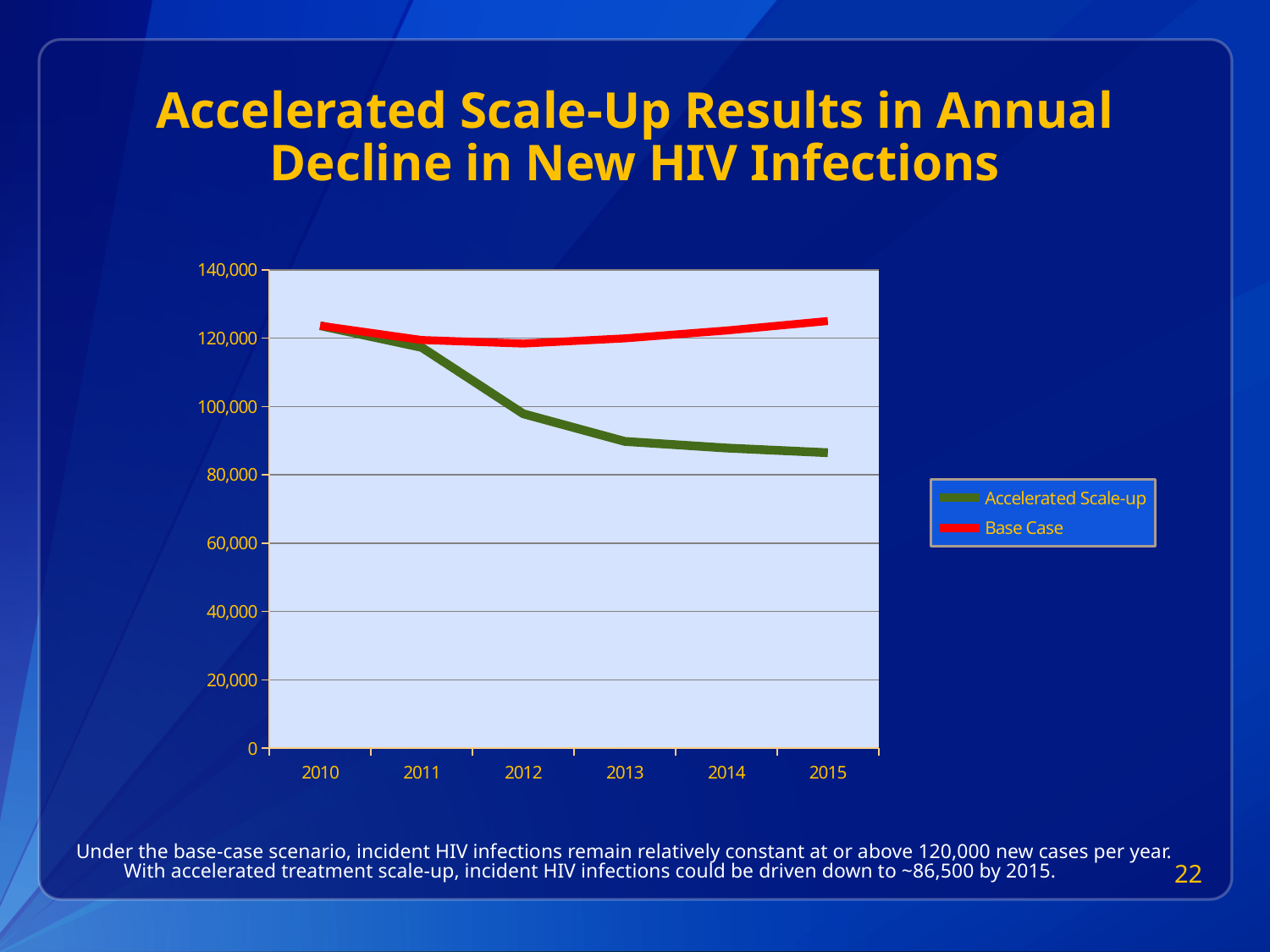
In 2015, which series has the higher value, Base Case or Accelerated Scale-up? Base Case Is the value for Accelerated Scale-up in 2013 greater or less than 100,000? less Which series is shown in red in the legend? Base Case In 2013, which series has the lower value, Base Case or Accelerated Scale-up? Accelerated Scale-up Is the value for Accelerated Scale-up in 2015 greater or less than 80,000? greater Which series is shown in green in the legend? Accelerated Scale-up How many series does the legend list? 2 Does the Accelerated Scale-up line rise or fall from 2010 to 2015? Fall Is the value for Accelerated Scale-up in 2015 greater or less than 100,000? less How many years are shown along the x axis? 6 What kind of chart is shown on the slide? Line chart